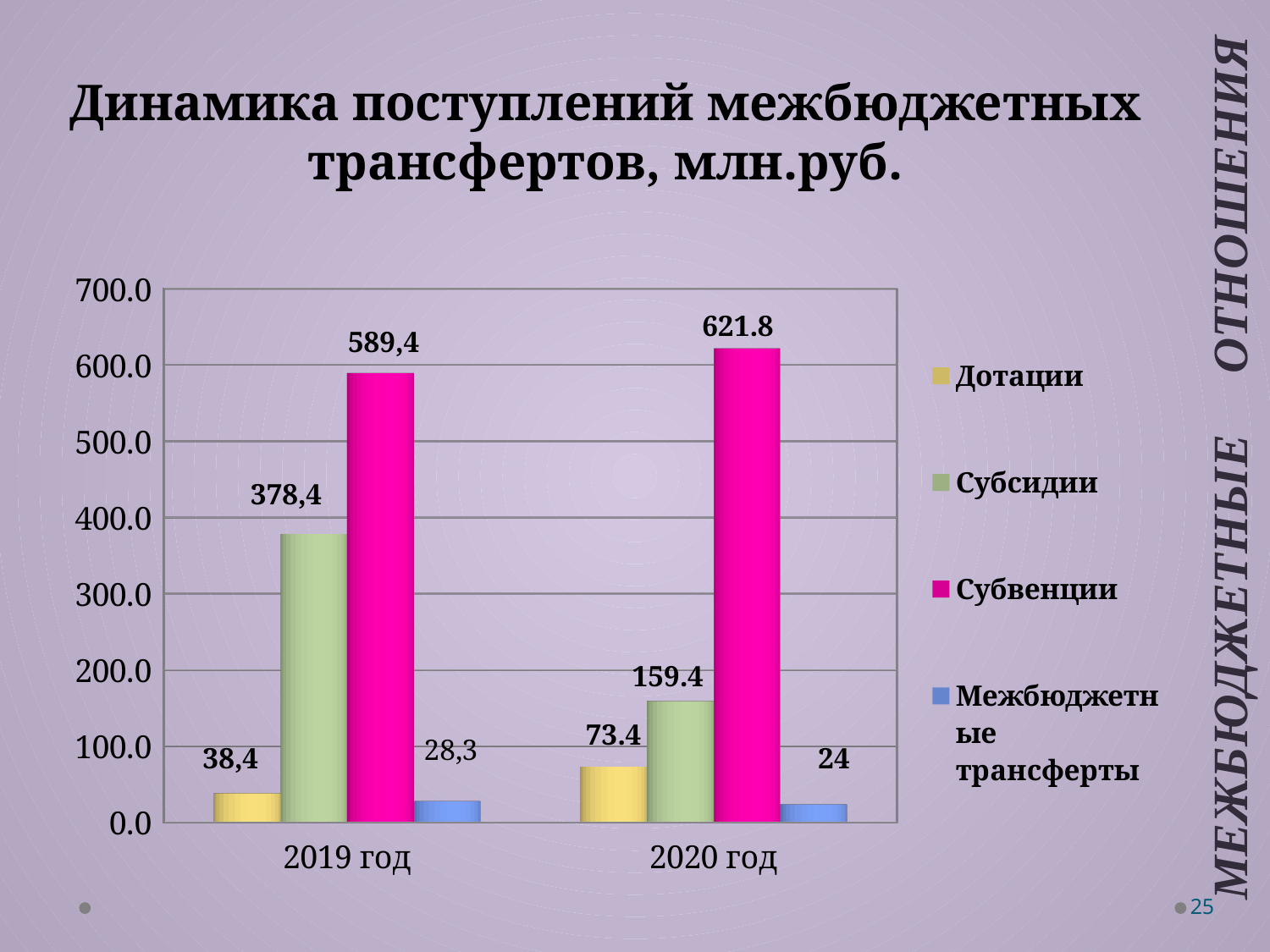
What is the value for Субсидии in 2020 год? 159.4 What is the value for Дотации in 2019 год? 38,4 Which is larger: Субвенции in 2019 год or Субвенции in 2020 год? 2020 год Did the value for Субсидии rise or fall from 2019 год to 2020 год? fall By how much did Дотации increase from 2019 год to 2020 год? 35 How many series does the legend list? 4 Which series has the lowest value in 2019 год? Межбюджетные трансферты What is the value for Межбюджетные трансферты in 2020 год? 24 What is the value for Субвенции in 2019 год? 589,4 By how much did Субсидии decrease from 2019 год to 2020 год? 219 Which series has the highest value in 2020 год? Субвенции What type of chart is shown on the slide? bar chart